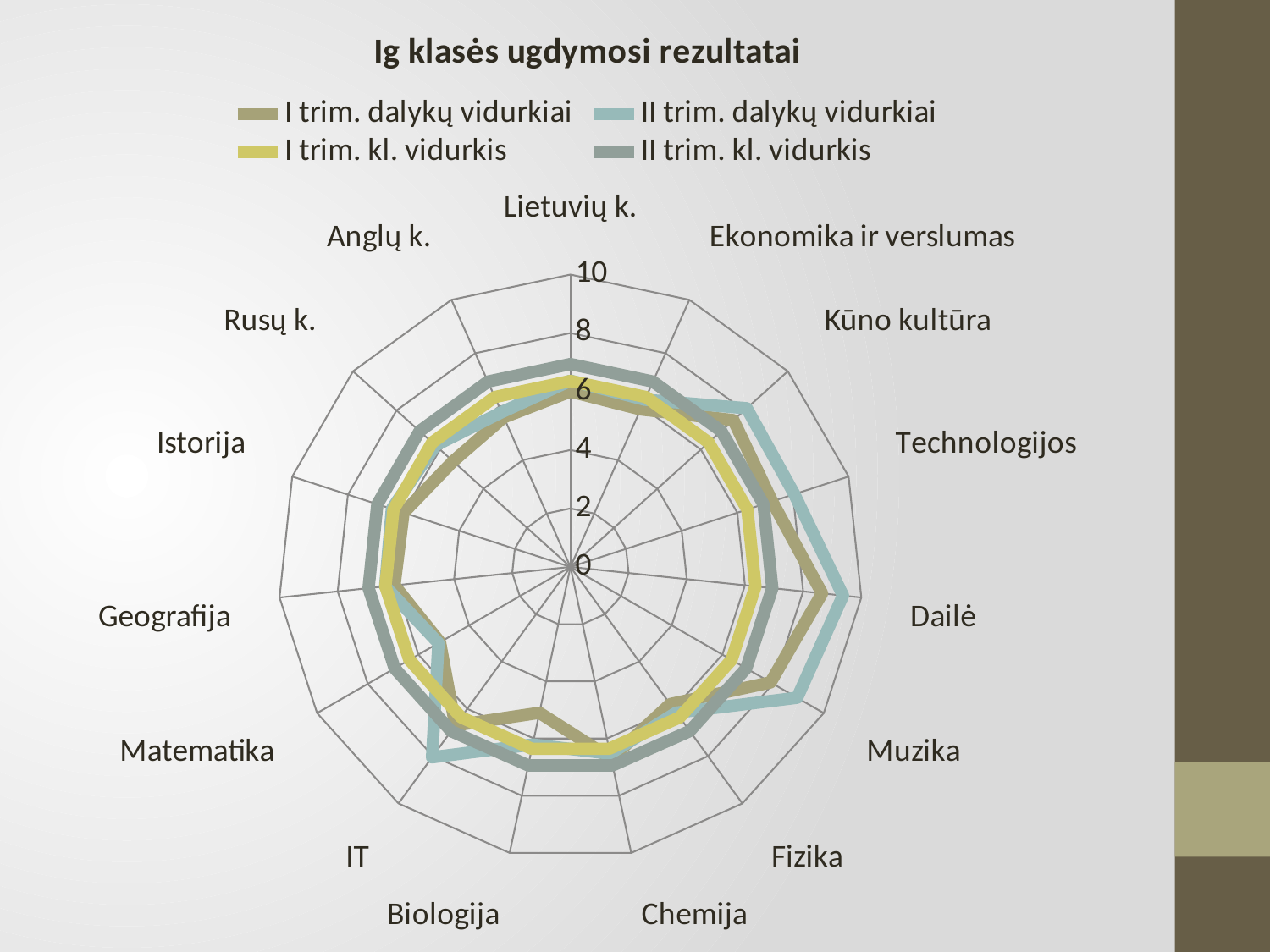
For II trim. dalykų vidurkiai, which is larger: Dailė or Biologija? Dailė Is the I trim. dalykų vidurkiai value for Istorija greater or less than 8? less Which subject has the highest value for I trim. dalykų vidurkiai? Dailė What is the maximum value shown on the chart's axis scale? 10 What is the title of the chart? Ig klasės ugdymosi rezultatai Which subject has the highest value for II trim. dalykų vidurkiai? Dailė How many series does the legend list? 4 Is the II trim. dalykų vidurkiai value for Lietuvių k. greater or less than 8? less Is the II trim. dalykų vidurkiai value for Dailė greater or less than 8? greater How many subject categories are plotted around the chart? 15 What kind of chart is shown on the slide? radar chart